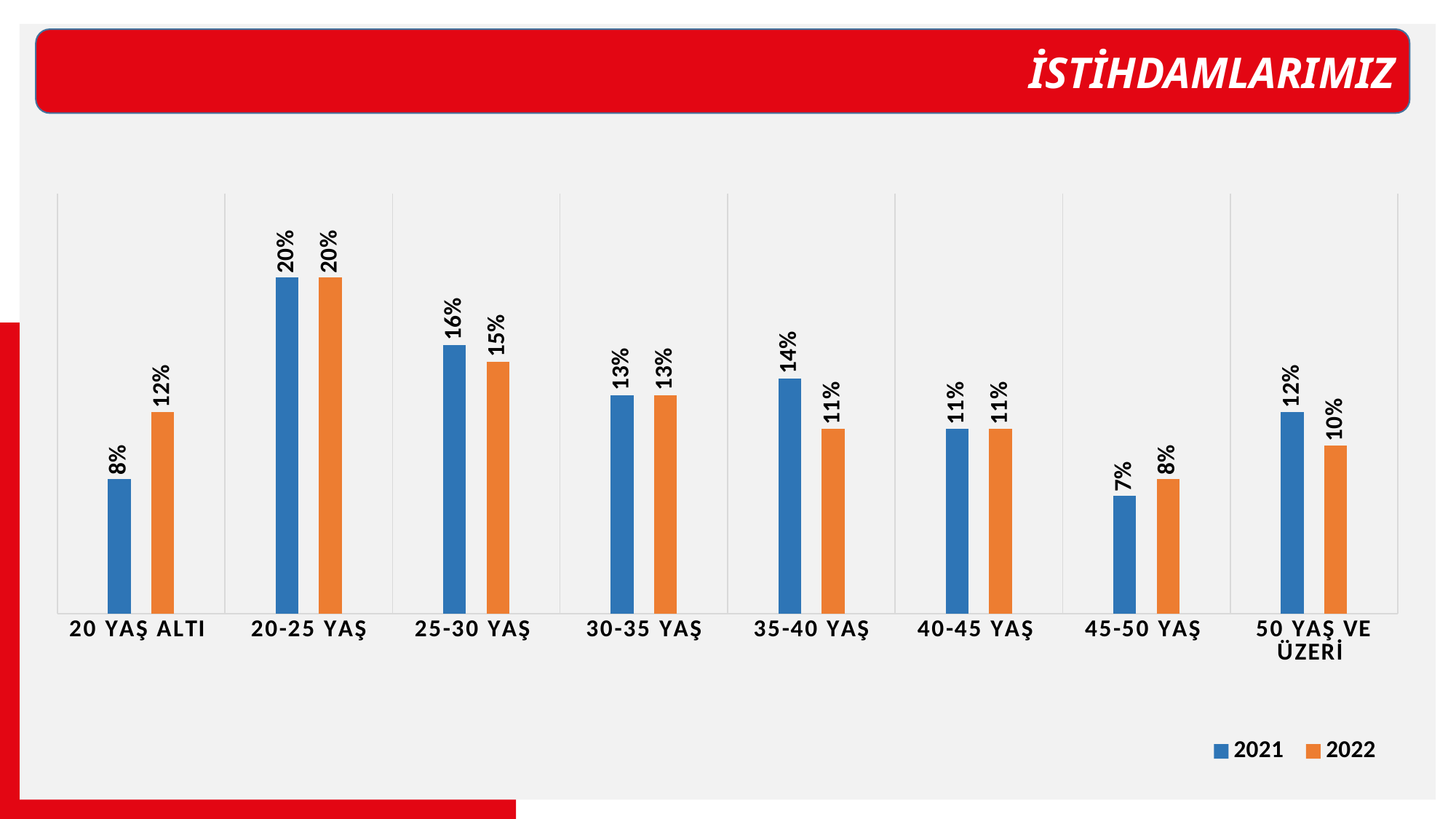
What is the 2021 value for 35-40 YAŞ? 14% What is the 2022 value for 50 YAŞ VE ÜZERİ? 10% Which is larger for 35-40 YAŞ, the 2021 value or the 2022 value? 2021 What kind of chart is shown on the slide? Bar chart What is the 2022 value for 25-30 YAŞ? 15% How many age groups are shown on the x axis? 8 What colour represents the 2022 series? Orange Which age group has the highest 2021 value? 20-25 YAŞ What is the 2021 value for 20 YAŞ ALTI? 8% Which age group has the lowest 2021 value? 45-50 YAŞ What is the difference between the 2021 and 2022 values for 20 YAŞ ALTI? 4% How many series does the legend list? 2